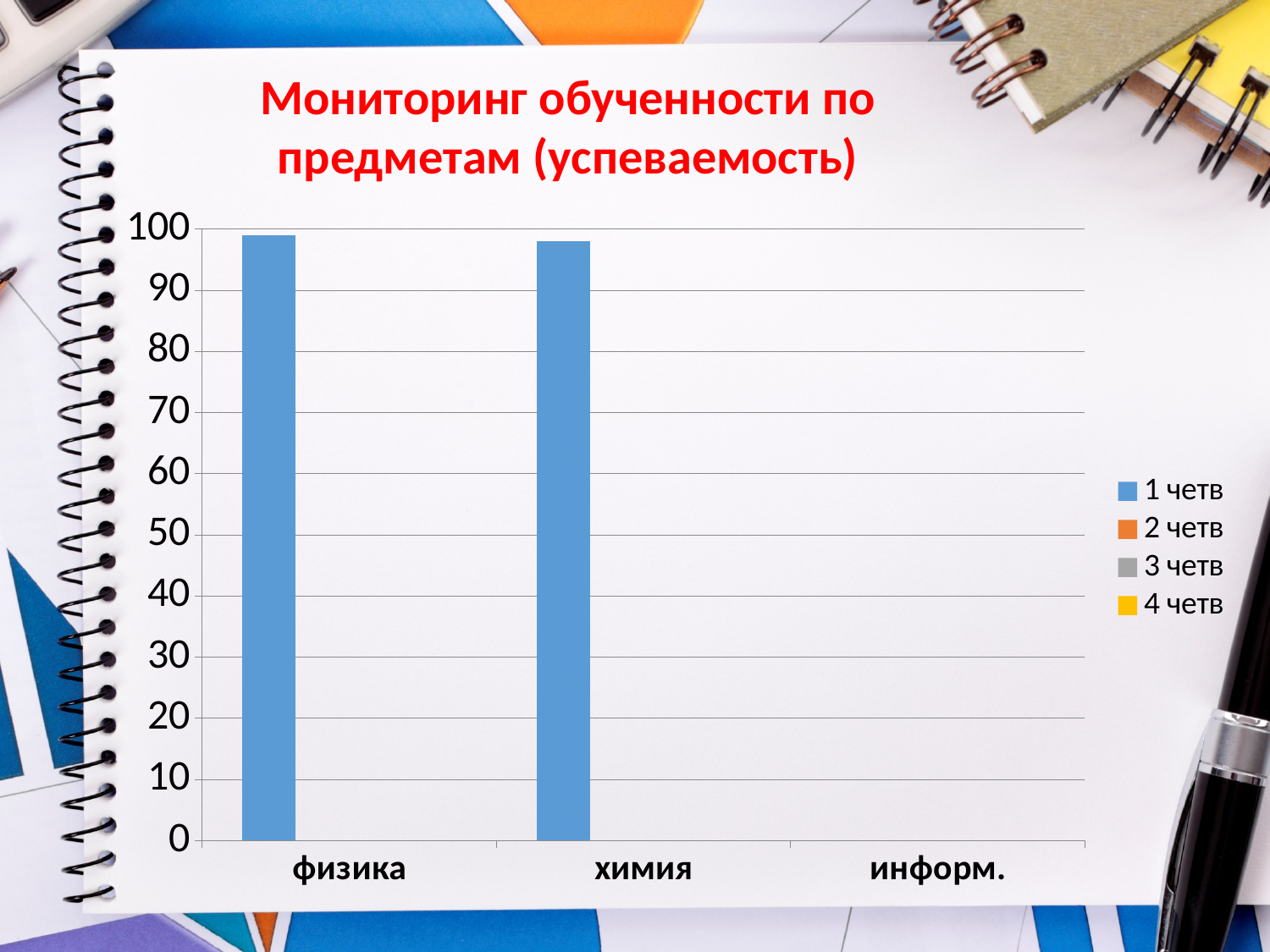
What is the highest value shown on the chart's vertical axis? 100 What is the title of the chart? Мониторинг обученности по предметам (успеваемость) How many series does the chart's legend list? 4 Which series in the legend is shown in blue? 1 четв Is the value for химия in the 1 четв series greater or less than 90? greater Is the value for химия in the 1 четв series greater or less than 80? greater What kind of chart is shown on the slide? bar chart How many categories are shown on the x axis of the chart? 3 Is the value for физика in the 1 четв series greater or less than 50? greater